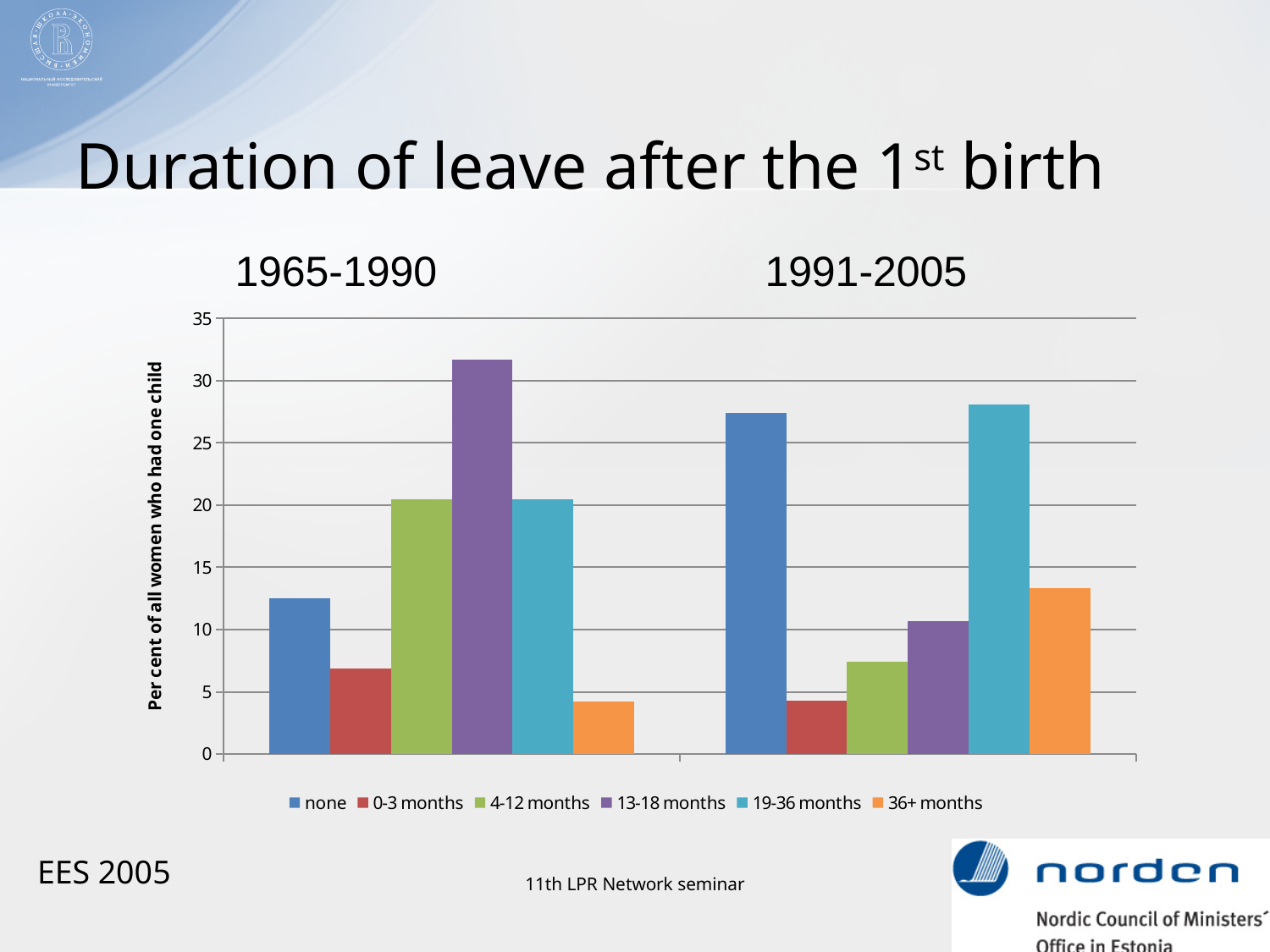
Which is larger: the value for none in 1965-1990 or the value for none in 1991-2005? 1991-2005 In the 1991-2005 group, which leave duration has the lowest value? 0-3 months Which is larger: the value for 13-18 months in 1965-1990 or in 1991-2005? 1965-1990 Is the value for 36+ months in 1965-1990 greater or less than 5? less In the 1965-1990 group, which leave duration has the highest value? 13-18 months How many series does the legend list? 6 Is the value for none in 1991-2005 greater or less than 25? greater Is the value for 13-18 months in 1965-1990 greater or less than 30? greater How many period groups are plotted along the x axis? 2 In the 1965-1990 group, which leave duration has the lowest value? 36+ months What is the label of the vertical axis? Per cent of all women who had one child What kind of chart is shown on the slide? bar chart